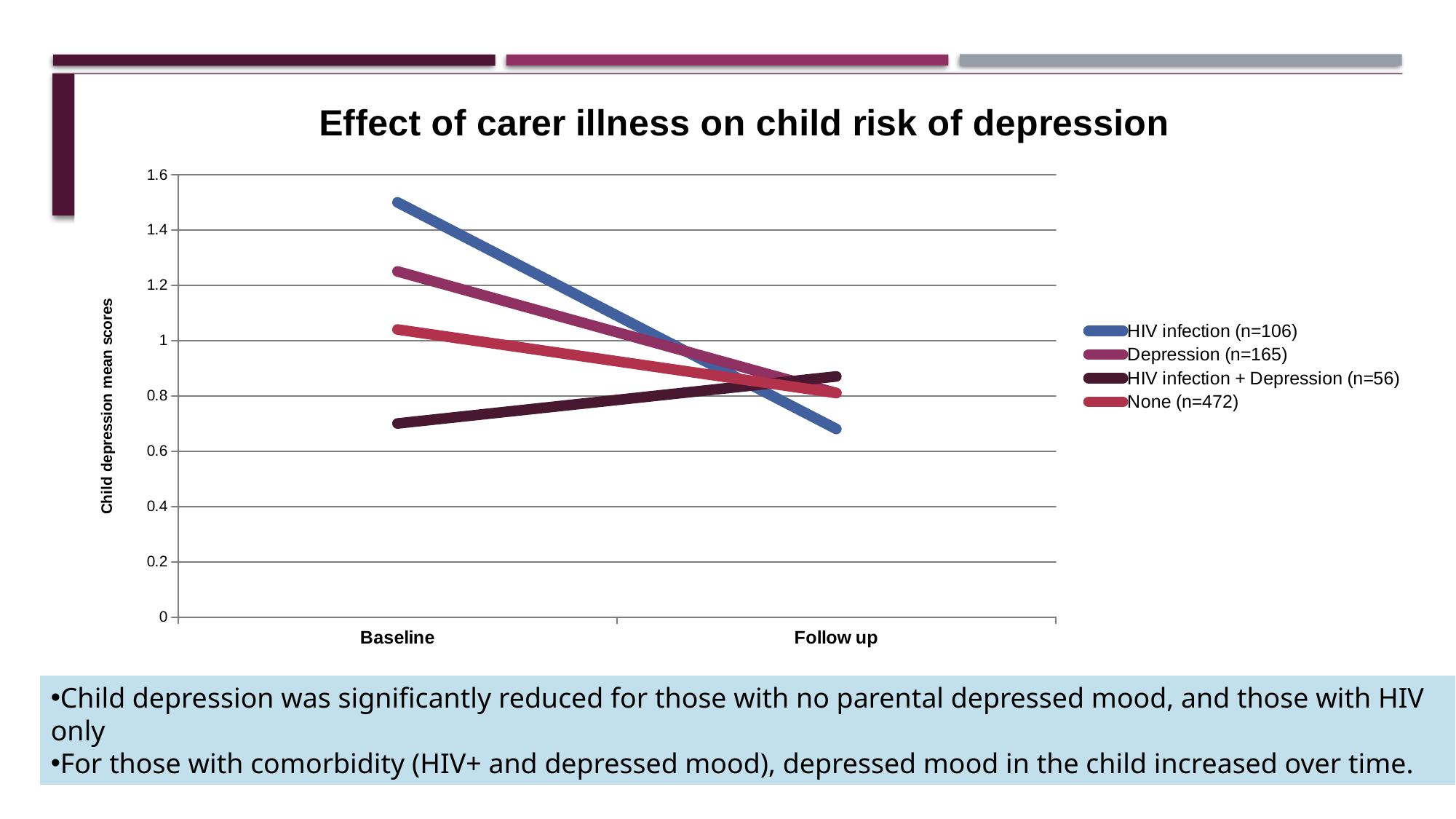
Is the value for HIV infection (n=106) at Baseline greater or less than 1.4? greater Which series has the highest value at Baseline? HIV infection (n=106) Is the value for HIV infection (n=106) at Follow up greater or less than 0.8? less Which series has the lowest value at Follow up? HIV infection (n=106) How many points are on the x axis? 2 Does the HIV infection + Depression (n=56) line rise or fall from Baseline to Follow up? rise How many series does the legend list? 4 What is the label of the y axis? Child depression mean scores Is the value for HIV infection + Depression (n=56) at Baseline greater or less than 0.8? less Does the HIV infection (n=106) line rise or fall from Baseline to Follow up? fall What kind of chart is shown on the slide? line chart Which series has the lowest value at Baseline? HIV infection + Depression (n=56)